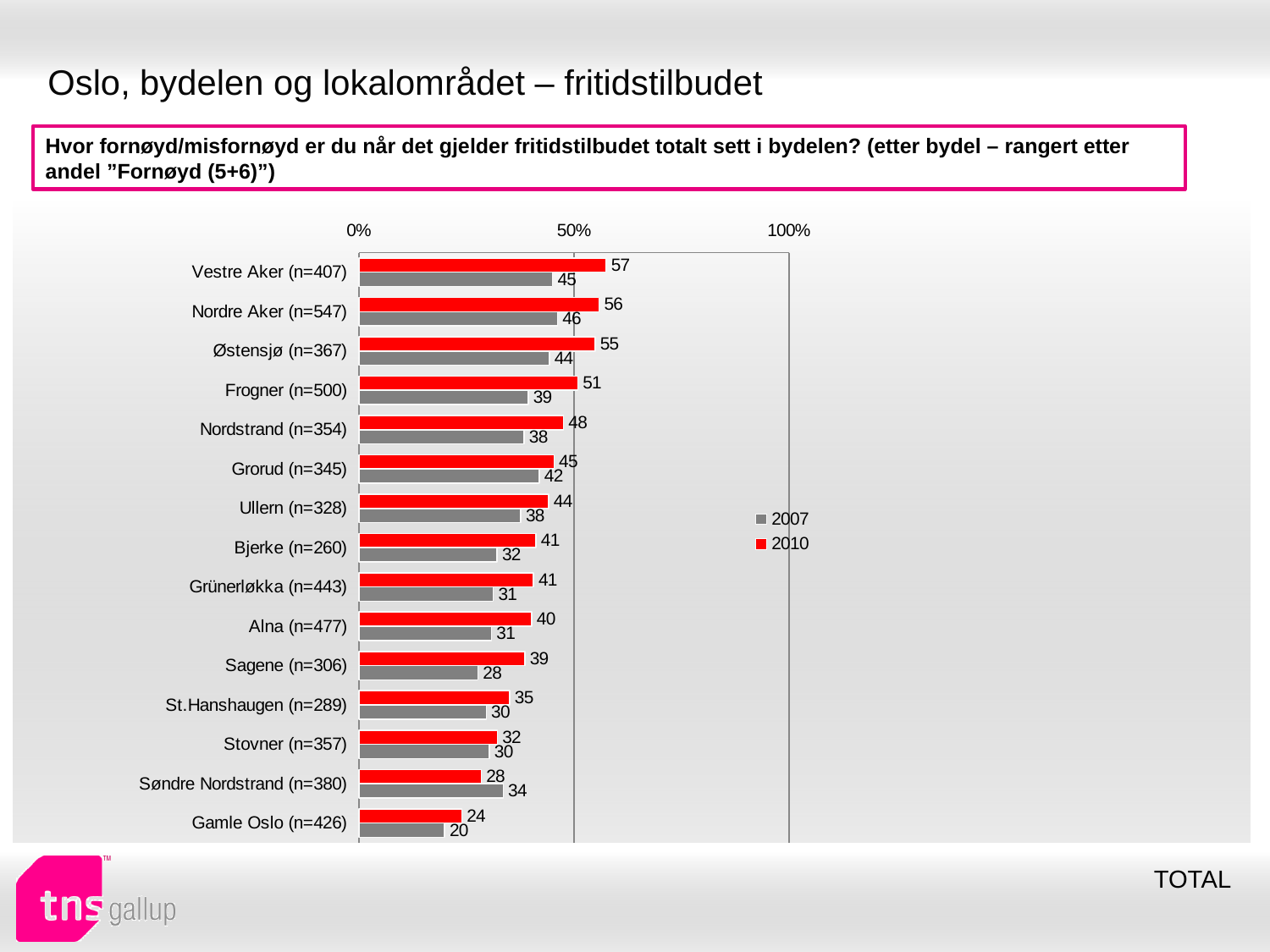
What kind of chart is shown on the slide? Bar chart How many series does the legend list? 2 Which colour represents the 2010 series in the chart? Red What is the 2007 value for Søndre Nordstrand (n=380)? 34 Is the 2010 value for Nordre Aker (n=547) greater or less than 50%? greater Which bydel has the lowest 2007 value? Gamle Oslo (n=426) Which bydel has the highest 2010 value? Vestre Aker (n=407) What is the difference between the 2010 and 2007 values for Frogner (n=500)? 12 How many bydeler (categories) are shown in the chart? 15 For Søndre Nordstrand (n=380), which is larger: the 2007 value or the 2010 value? 2007 What is the 2010 value for Vestre Aker (n=407)? 57 What is the 2007 value for Frogner (n=500)? 39